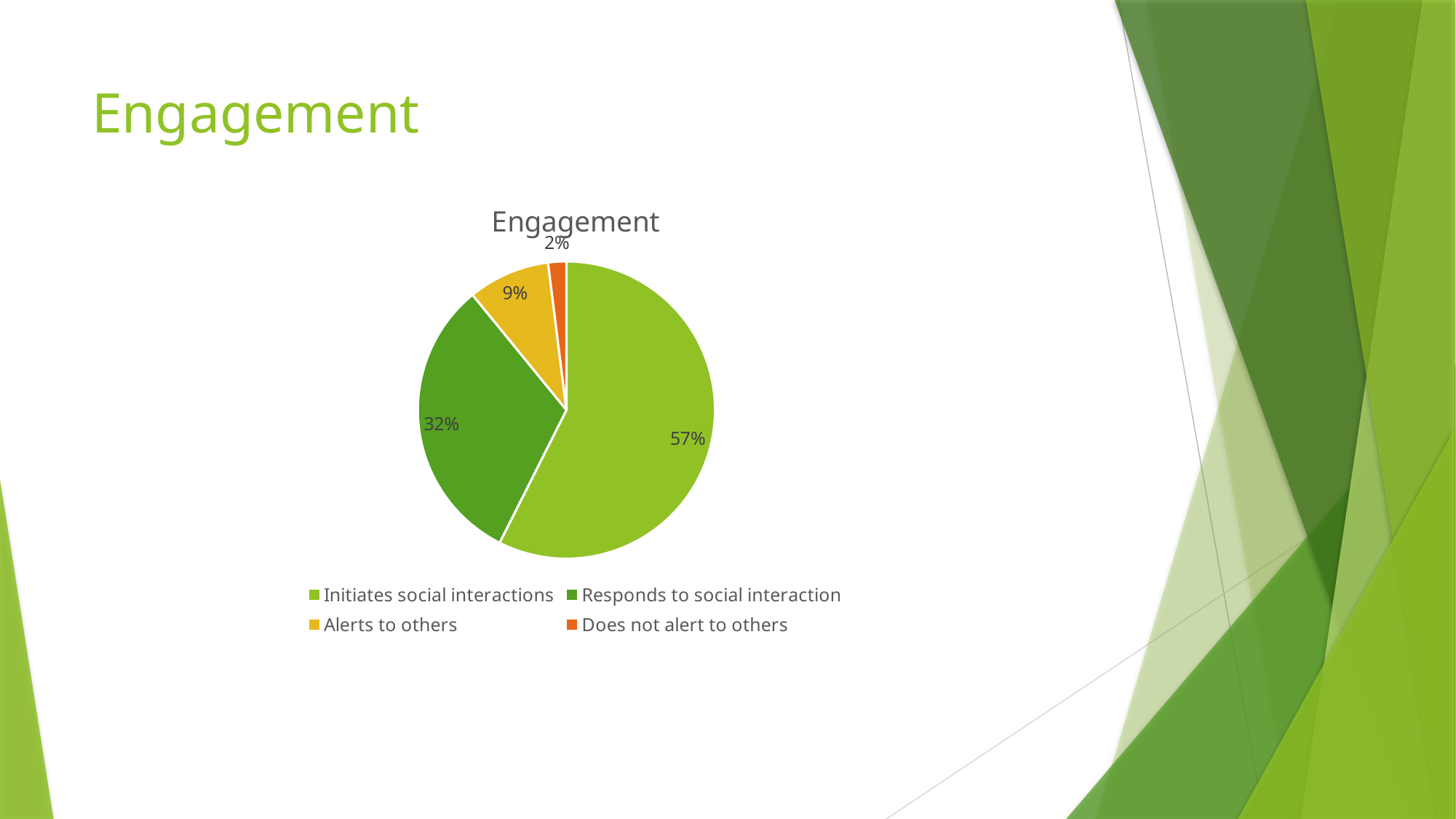
What kind of chart is shown on the slide? pie chart Which category has the smallest slice of the pie? Does not alert to others What is the difference in percentage points between 'Initiates social interactions' and 'Responds to social interaction'? 25 What share of the pie is 'Alerts to others'? 9% Which category has the largest slice of the pie? Initiates social interactions What colour is the slice for 'Alerts to others'? yellow What is the title of the chart? Engagement What share of the pie is 'Does not alert to others'? 2% What share of the pie is 'Initiates social interactions'? 57% How many categories does the pie chart have? 4 Which is larger: 'Alerts to others' or 'Does not alert to others'? Alerts to others